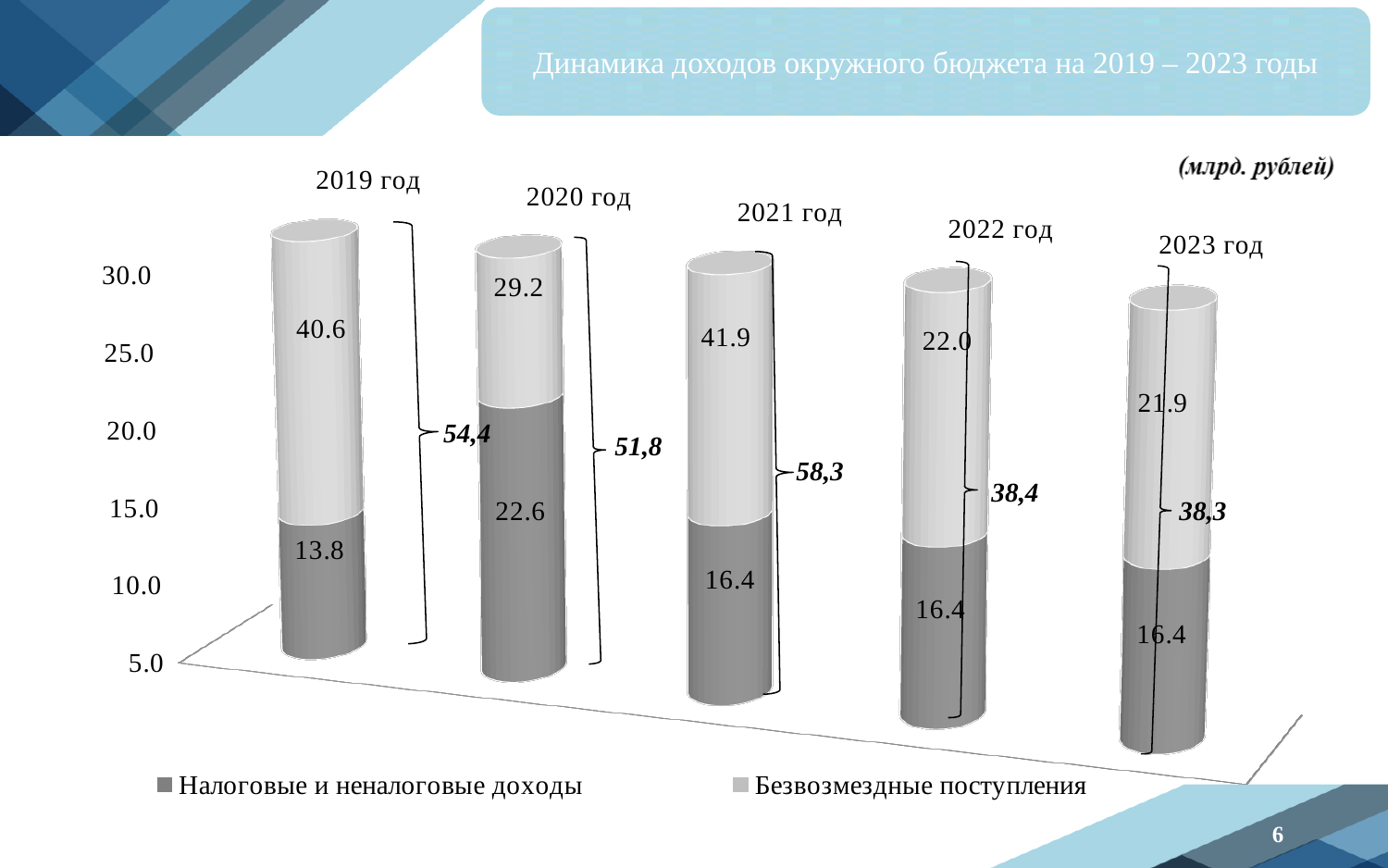
How many years are shown on the chart? 5 What is the value of Безвозмездные поступления for 2021 год? 41.9 Which year has the lowest value of Налоговые и неналоговые доходы? 2019 год Which is larger: Налоговые и неналоговые доходы in 2020 год or in 2022 год? 2020 год What is the value of Налоговые и неналоговые доходы for 2019 год? 13.8 What is the value of Налоговые и неналоговые доходы for 2020 год? 22.6 How many series does the legend list? 2 What kind of chart is shown on the slide? Stacked bar chart Which year has the highest value of Безвозмездные поступления? 2021 год What is the difference between Безвозмездные поступления in 2019 год and 2020 год? 11.4 What is the total of the stacked bar for 2021 год, as labelled on the slide? 58,3 What is the value of Безвозмездные поступления for 2023 год? 21.9